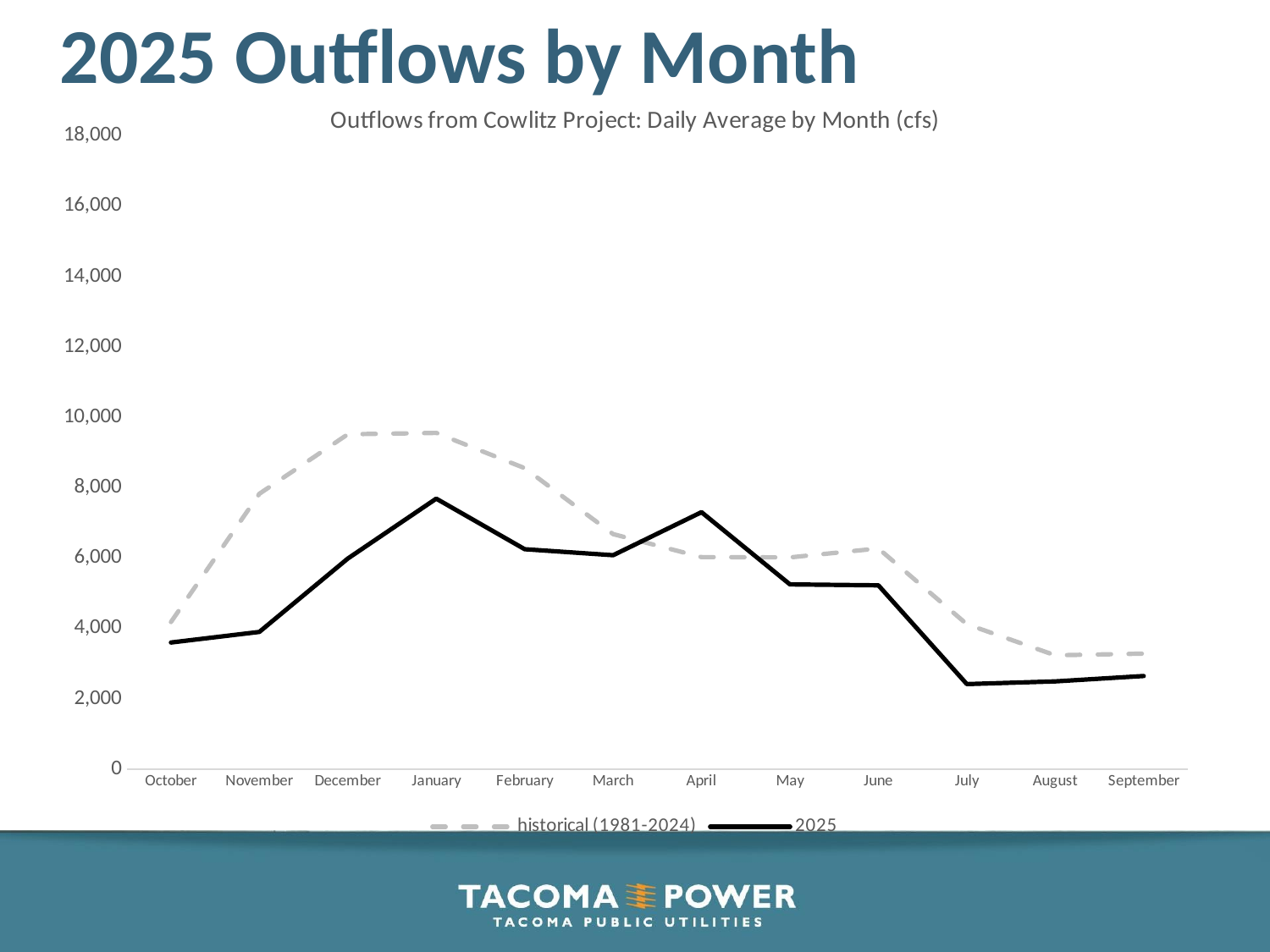
What kind of chart is shown on the slide? line chart How many series does the legend list? 2 In which month does the 2025 series reach its highest value? January How many months are shown along the x axis? 12 Is the historical (1981-2024) value for December greater or less than 8,000? greater What is the title of the chart? Outflows from Cowlitz Project: Daily Average by Month (cfs) Is the 2025 value for October greater or less than 4,000? less In April, which series has the larger value: historical (1981-2024) or 2025? 2025 Is the 2025 value for July greater or less than 4,000? less In December, which series has the larger value: historical (1981-2024) or 2025? historical (1981-2024) Does the 2025 series rise or fall from June to July? fall